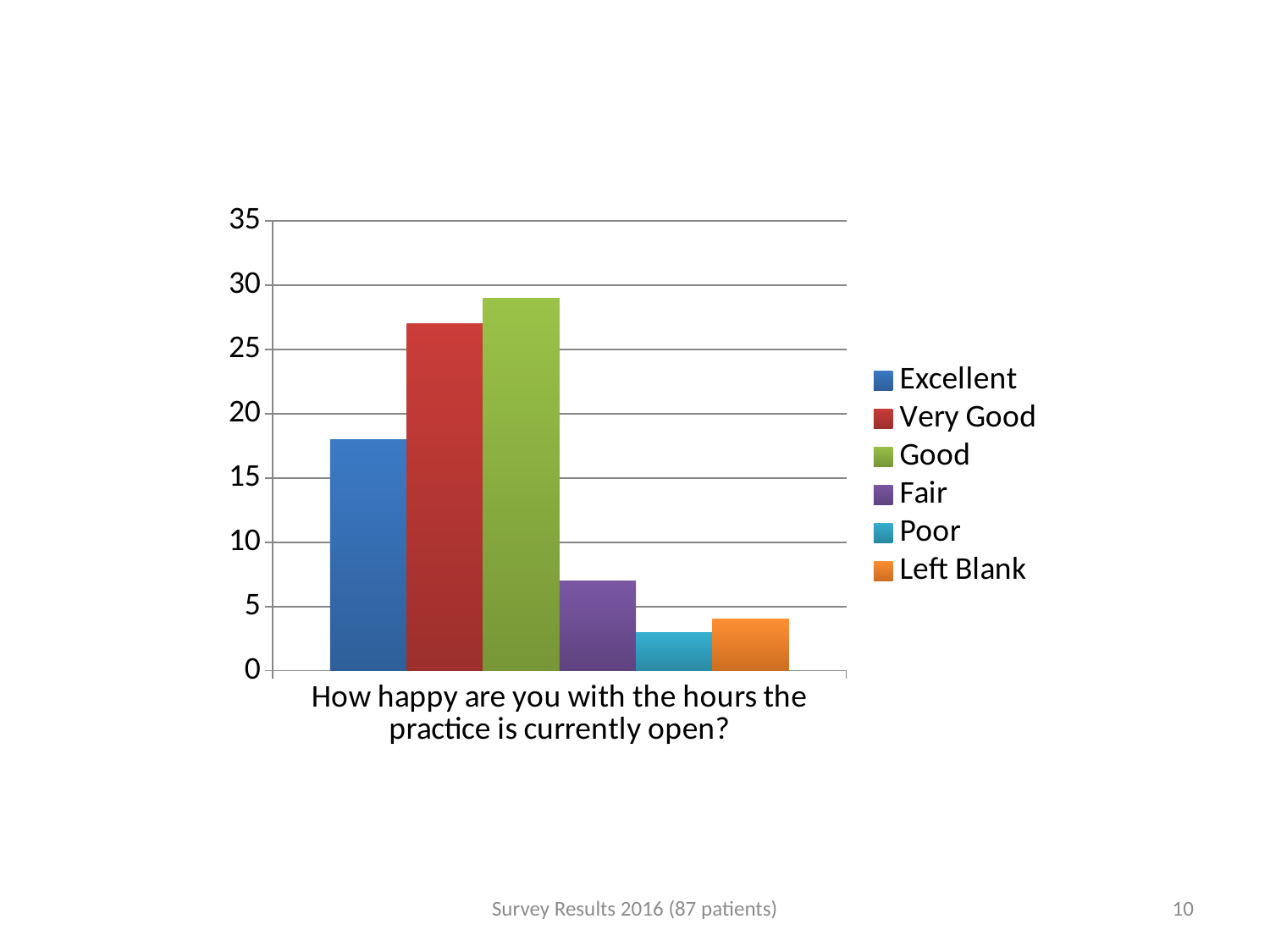
Which response category has the highest bar? Good What question is shown as the category label on the x axis? How happy are you with the hours the practice is currently open? How many series does the legend list? 6 Is the value for Poor greater or less than 5? less What kind of chart is shown on the slide? bar chart Which is larger, the value for Very Good or the value for Excellent? Very Good Is the value for Very Good greater or less than 25? greater Is the value for Fair greater or less than 10? less Which is larger, the value for Excellent or the value for Fair? Excellent